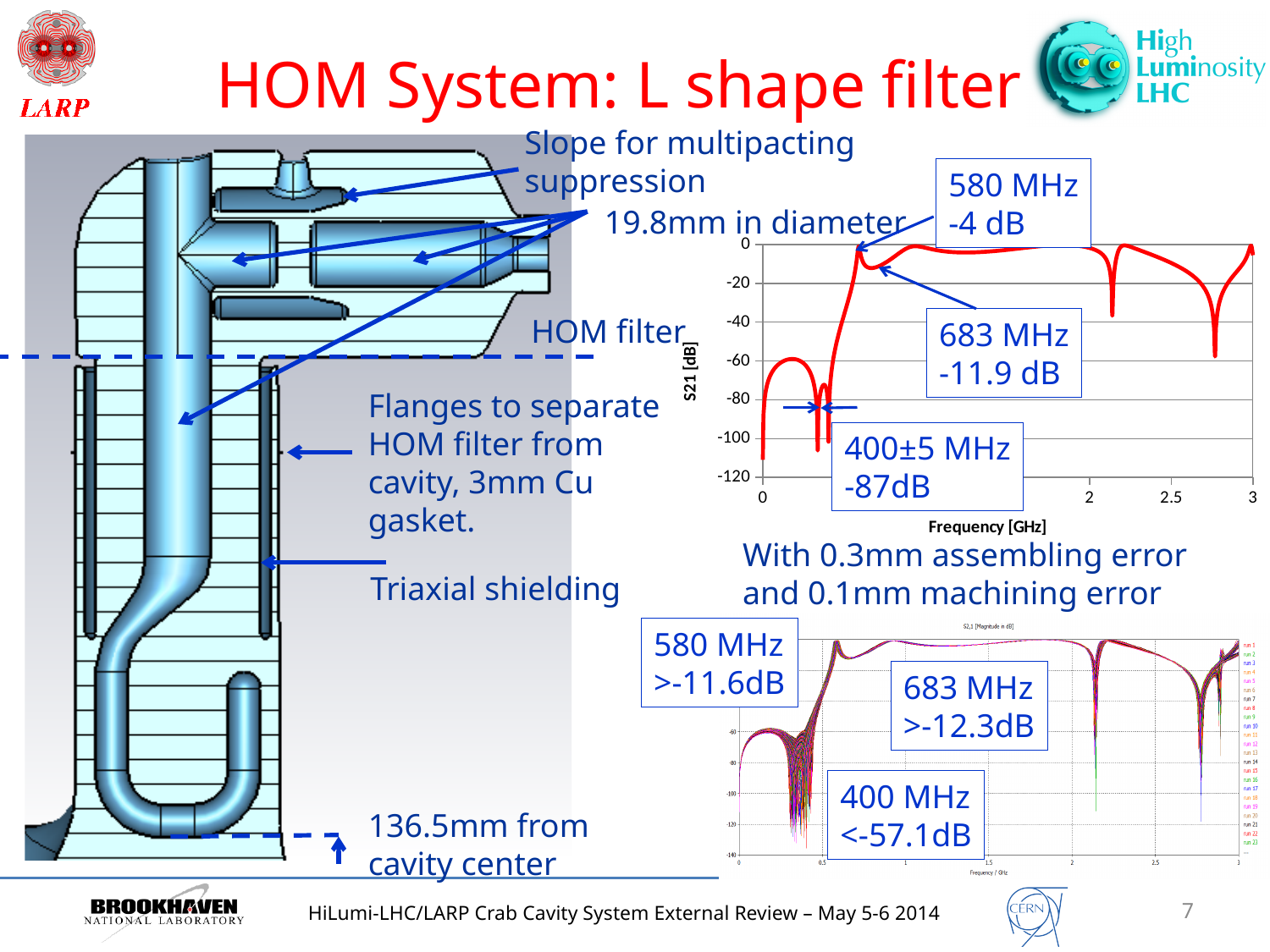
In the upper S21 chart, what is the label of the x axis? Frequency [GHz] In the upper S21 chart, is the S21 value at 1 GHz greater or less than -20 dB? greater In the upper S21 chart, which labelled frequency has the higher S21 value, 580 MHz or 683 MHz? 580 MHz In the lower chart with assembling and machining errors, what is the S21 value labelled at 683 MHz? >-12.3dB In the upper S21 chart, what is the S21 value labelled at 580 MHz? -4 dB In the upper S21 chart, what is the S21 value labelled at 683 MHz? -11.9 dB In the lower chart with assembling and machining errors, what is the S21 value labelled at 400 MHz? <-57.1dB In the upper S21 chart, what is the label of the y axis? S21 [dB] In the upper S21 chart, what is the difference between the labelled S21 values at 580 MHz and 683 MHz? 7.9 dB In the upper S21 chart, what is the S21 value labelled at 400±5 MHz? -87dB In the lower chart with assembling and machining errors, what is the S21 value labelled at 580 MHz? >-11.6dB What kind of chart is the upper S21 versus frequency chart? line chart